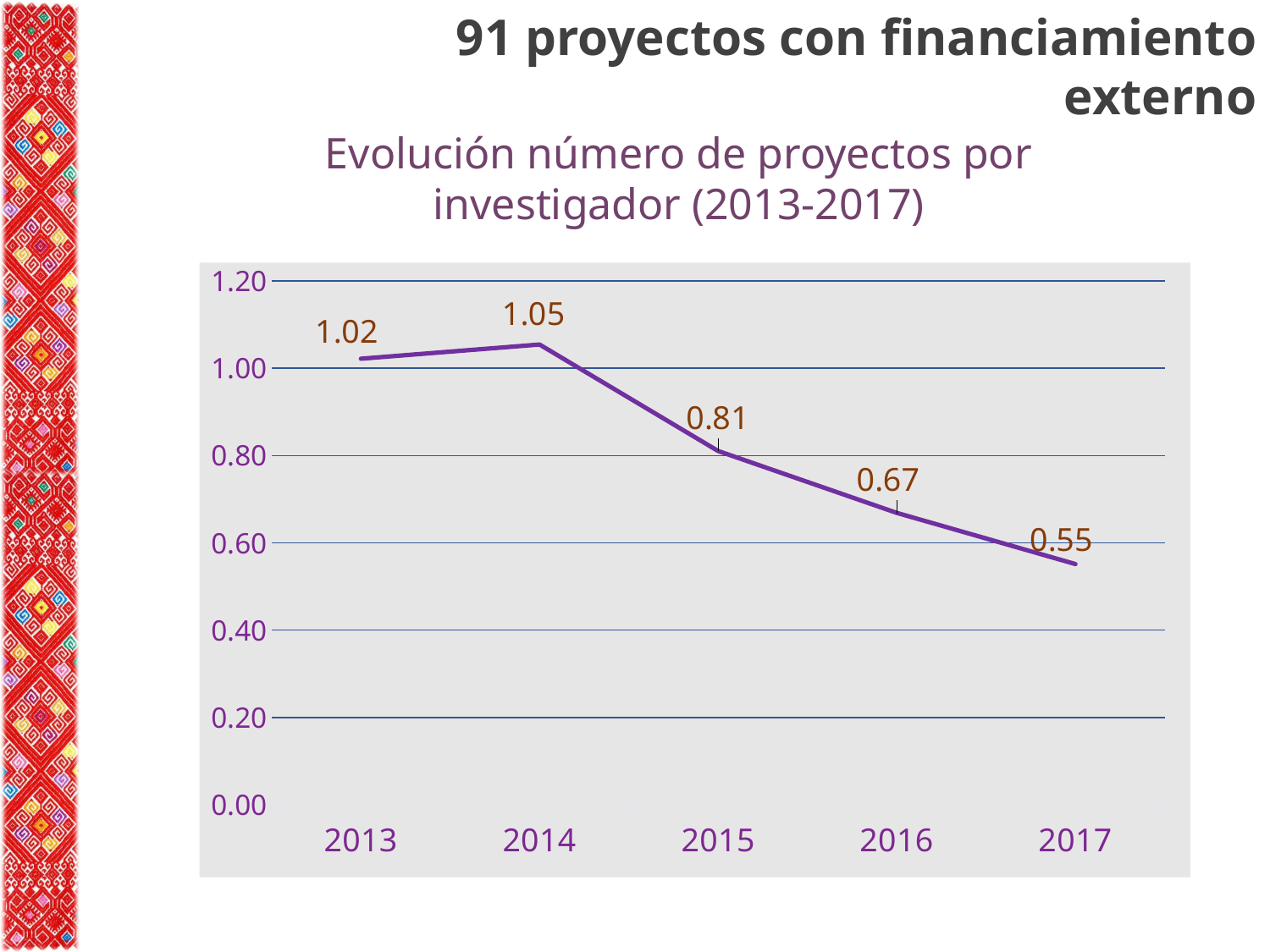
Which year has the lowest value? 2017 What is the difference between the values for 2015 and 2016? 0.14 How many years are plotted on the chart? 5 Is the value for 2016 greater or less than 0.80? less Which year has the highest value? 2014 What is the value for 2013? 1.02 What is the value for 2015? 0.81 Which is larger, the value for 2013 or the value for 2016? 2013 What is the value for 2017? 0.55 Do the values rise or fall from 2014 to 2017? fall What is the difference between the values for 2014 and 2017? 0.50 What kind of chart is shown? line chart